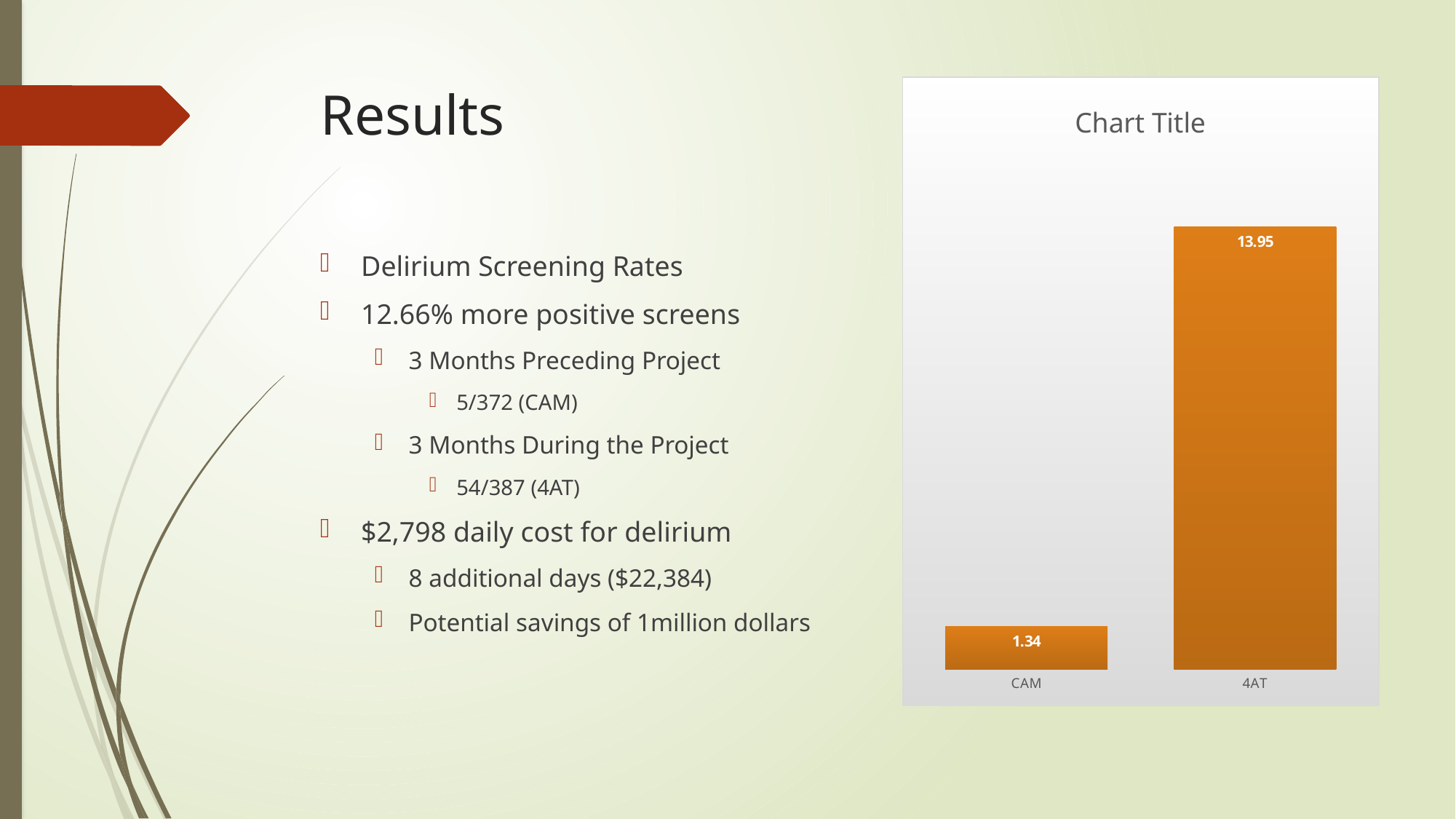
Do the values rise or fall from CAM to 4AT? rise What is the value for CAM? 1.34 Which is larger, the value for CAM or the value for 4AT? 4AT What colour are the bars in the chart? orange Which category has the lowest value? CAM What is the value for 4AT? 13.95 What is the difference between the values for 4AT and CAM? 12.61 What kind of chart is shown on the slide? bar chart What is the title of the chart? Chart Title How many categories are shown in the chart? 2 Which category has the highest value? 4AT